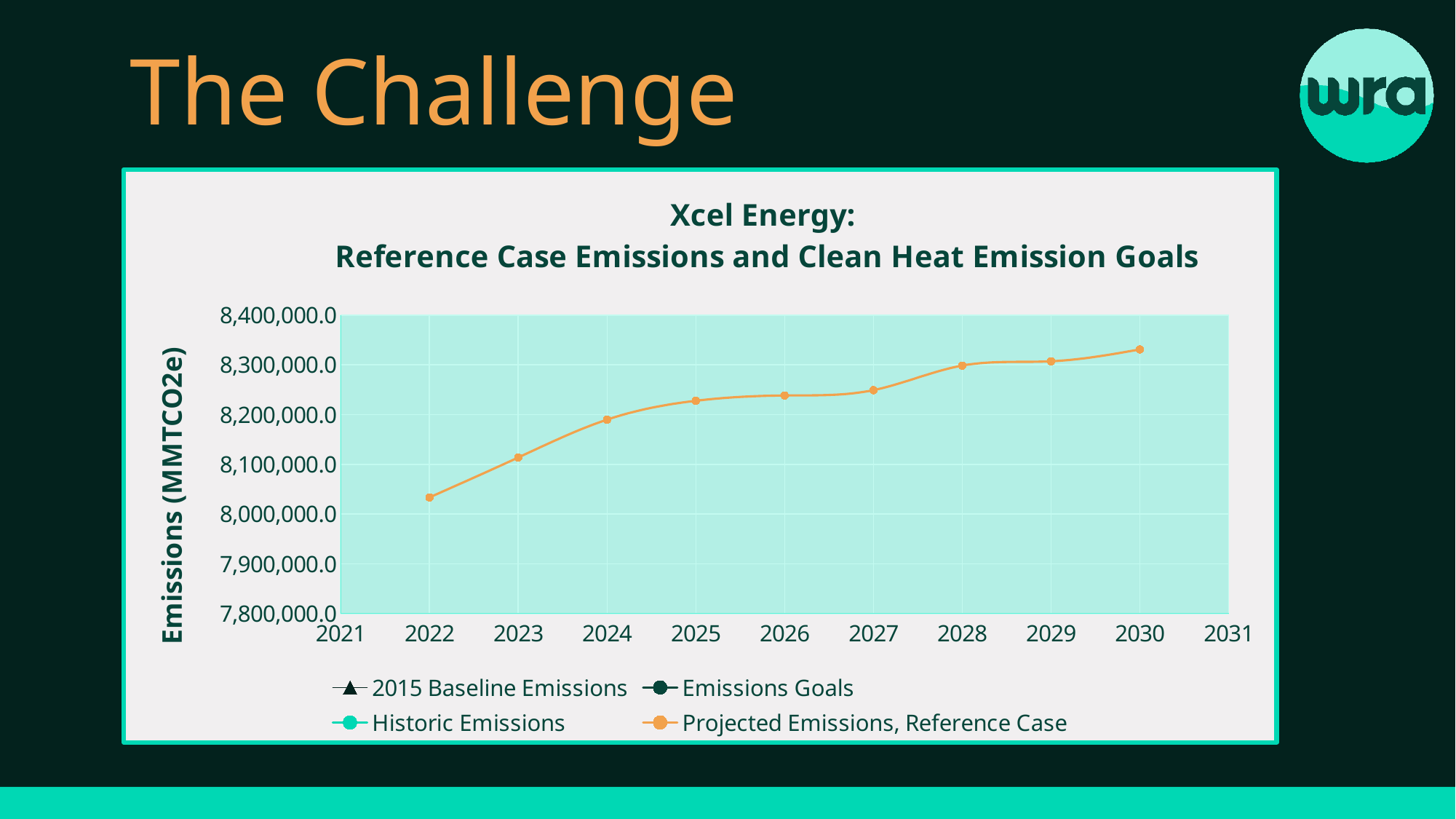
How many data points are plotted on the Projected Emissions, Reference Case line? 9 Is the projected emissions value for 2030 greater or less than 8,300,000.0? greater Which year has the lowest projected emissions on the Projected Emissions, Reference Case line? 2022 How many series does the chart's legend list? 4 Which year has higher projected emissions, 2022 or 2024? 2024 Which year has the highest projected emissions on the Projected Emissions, Reference Case line? 2030 Do the projected emissions rise or fall from 2022 to 2030? Rise What is the title of the chart? Xcel Energy: Reference Case Emissions and Clean Heat Emission Goals What kind of chart is shown on the slide? Line chart Is the projected emissions value for 2025 greater or less than 8,200,000.0? greater Is the projected emissions value for 2022 greater or less than 8,100,000.0? less